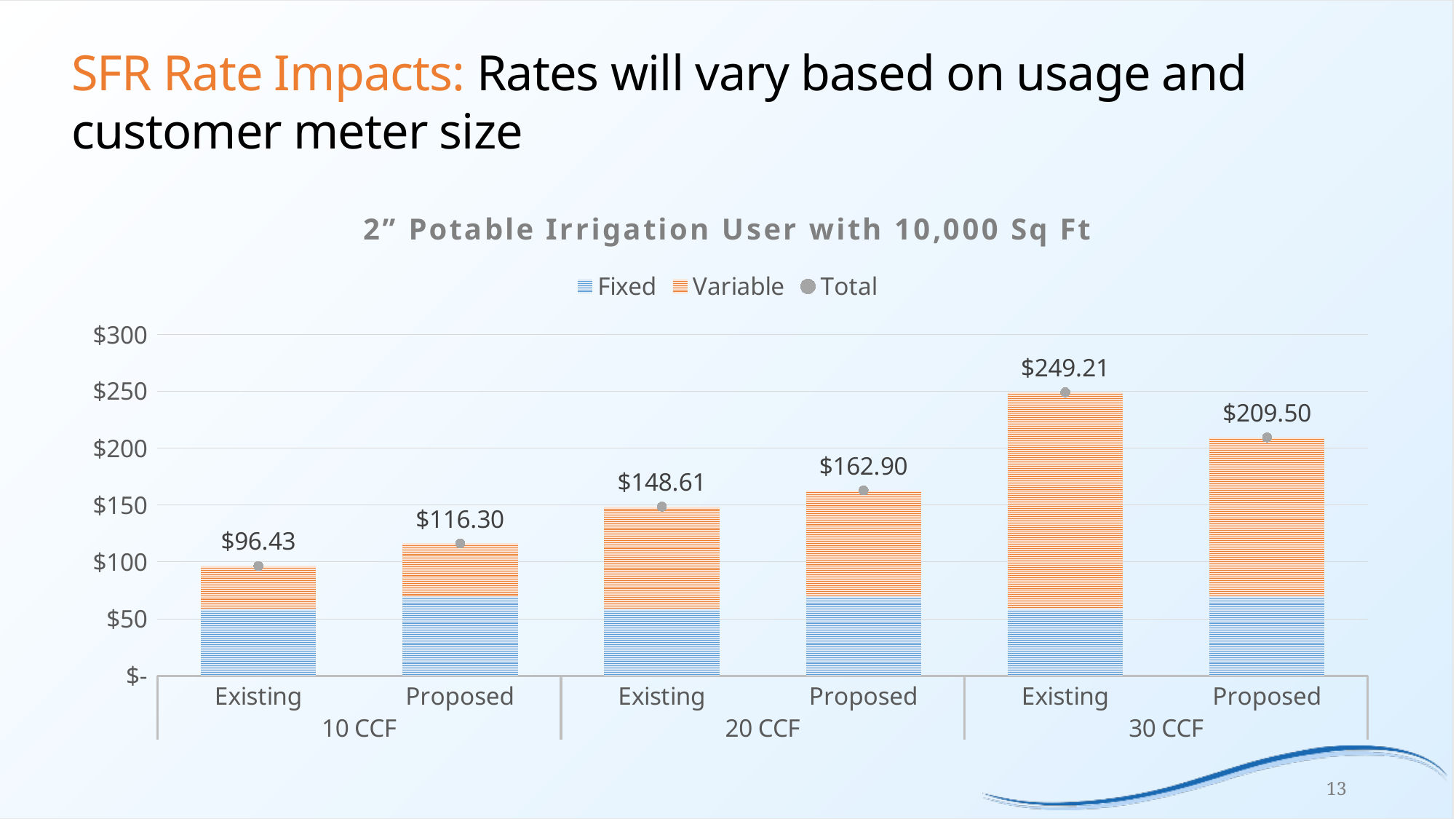
What kind of chart is shown on the slide? Stacked bar chart What is the Total for the Proposed bar at 20 CCF? $162.90 What is the Total for the Proposed bar at 30 CCF? $209.50 How many series does the legend list? 3 Which bar has the lowest Total? Existing, 10 CCF How many bars are plotted in the chart? 6 At 20 CCF, which is larger, the Existing Total or the Proposed Total? Proposed What is the difference between the Proposed and Existing Totals at 10 CCF? $19.87 Which bar has the highest Total? Existing, 30 CCF What is the Total for the Existing bar at 10 CCF? $96.43 Is the Fixed portion of the Existing bar at 10 CCF greater or less than $100? less What is the difference between the Existing and Proposed Totals at 30 CCF? $39.71